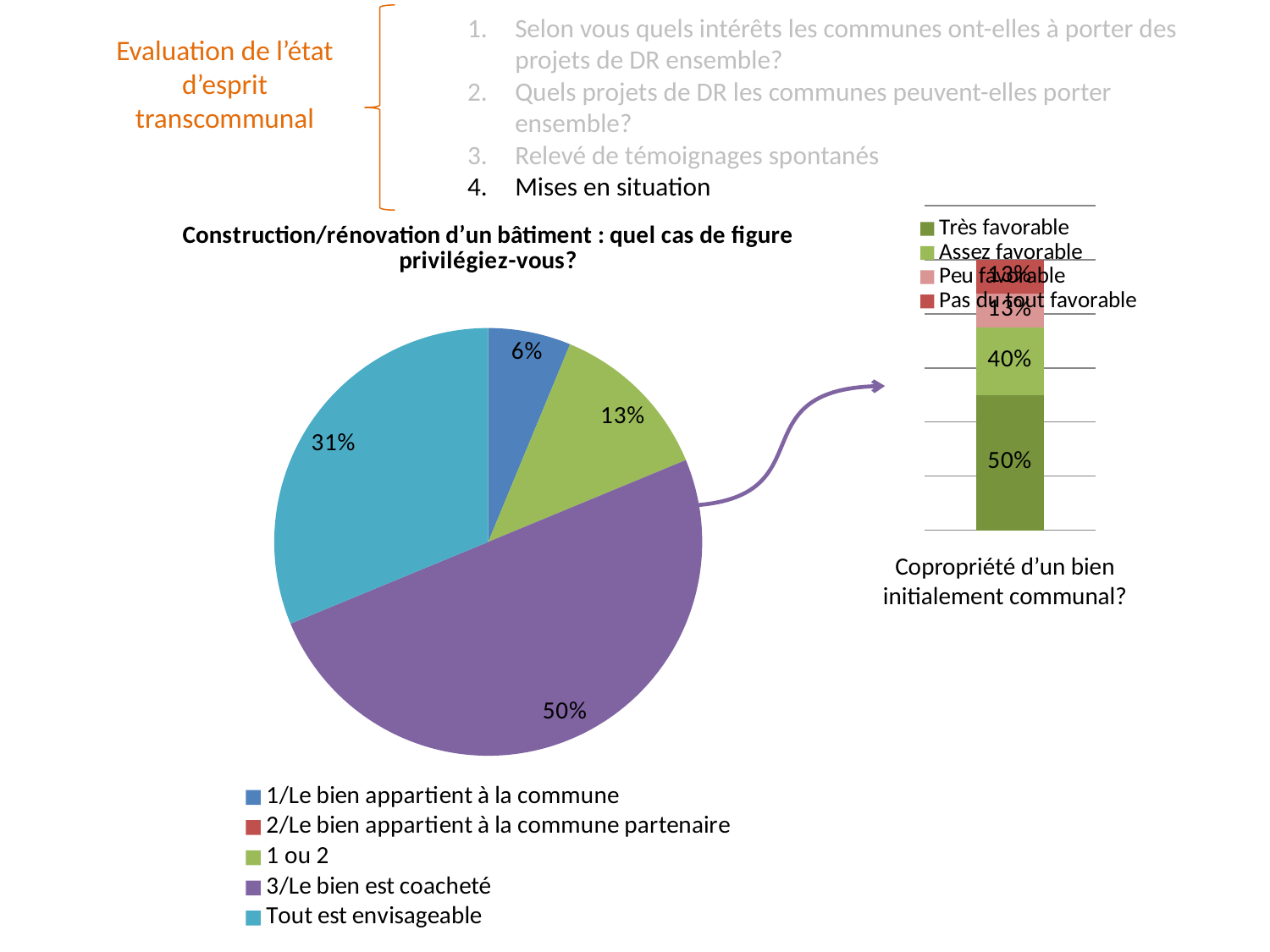
What kind of chart is the chart on the right titled 'Copropriété d'un bien initialement communal?'? Stacked bar chart In the pie chart 'Construction/rénovation d'un bâtiment', what share is shown for '1 ou 2'? 13% In the pie chart 'Construction/rénovation d'un bâtiment', which labelled slice is the smallest? 1/Le bien appartient à la commune In the pie chart 'Construction/rénovation d'un bâtiment', what is the difference between the shares for '3/Le bien est coacheté' and 'Tout est envisageable'? 19% In the pie chart 'Construction/rénovation d'un bâtiment', what share is shown for 'Tout est envisageable'? 31% In the stacked bar chart 'Copropriété d'un bien initialement communal?', what value is shown for 'Assez favorable'? 40% In the pie chart 'Construction/rénovation d'un bâtiment', which is larger: the share for '1 ou 2' or the share for 'Tout est envisageable'? Tout est envisageable How many entries does the legend of the pie chart 'Construction/rénovation d'un bâtiment' list? 5 In the pie chart 'Construction/rénovation d'un bâtiment', what share is shown for '1/Le bien appartient à la commune'? 6% In the stacked bar chart 'Copropriété d'un bien initialement communal?', what value is shown for 'Très favorable'? 50% In the pie chart 'Construction/rénovation d'un bâtiment', which category has the largest slice? 3/Le bien est coacheté In the pie chart 'Construction/rénovation d'un bâtiment : quel cas de figure privilégiez-vous?', what share is shown for '3/Le bien est coacheté'? 50%